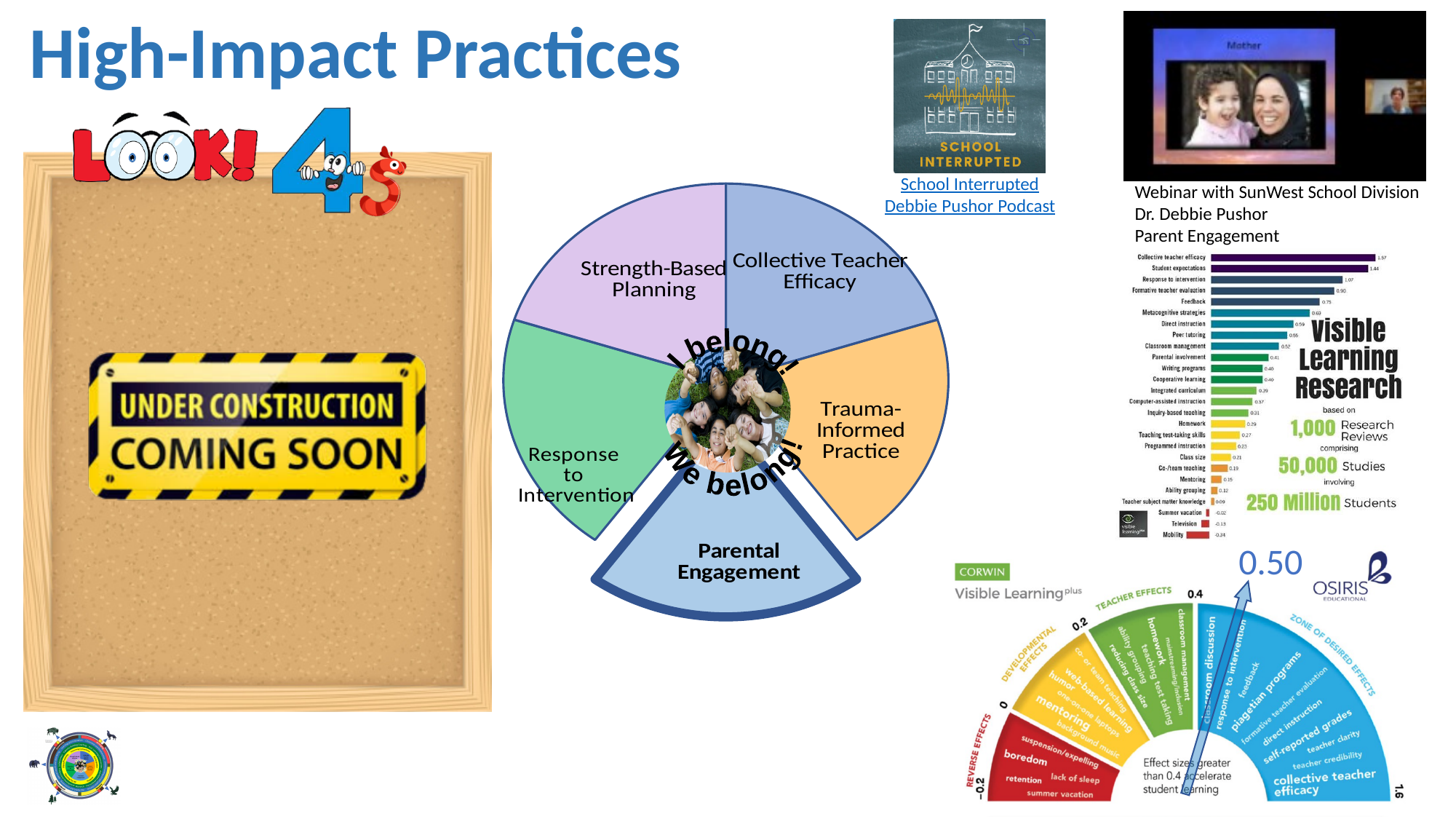
In the Visible Learning Research bar chart, what is the value for Collective teacher efficacy? 1.57 How many segments does the circular diagram in the centre of the slide have? 5 In the Visible Learning Research bar chart, what is the value for Feedback? 0.75 In the Visible Learning Research bar chart, which category has the lowest value? Mobility In the Visible Learning Research bar chart, what is the difference between Collective teacher efficacy and Student expectations? 0.13 In the Visible Learning Research bar chart, what is the value for Television? -0.13 In the Visible Learning Research bar chart, which is larger, Homework or Feedback? Feedback What kind of chart is the Visible Learning Research chart? bar chart In the Visible Learning Research bar chart, what is the value for Parental involvement? 0.41 In the Visible Learning Research bar chart, which category has the highest value? Collective teacher efficacy What kind of chart is the circular diagram in the centre of the slide? pie chart In the circular diagram in the centre of the slide, which segment is highlighted with a thick dark border? Parental Engagement